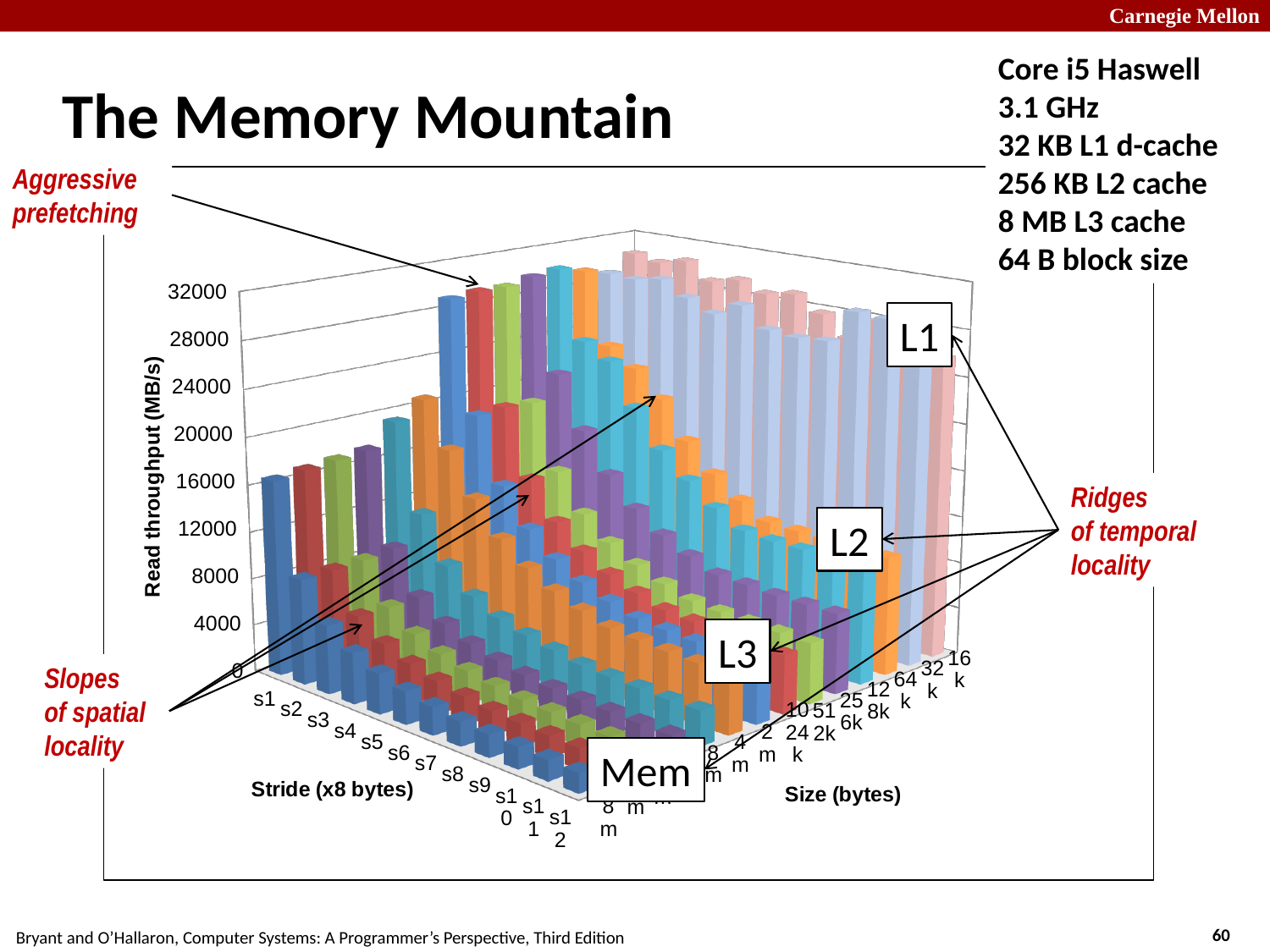
For a given size, does read throughput rise or fall as the stride increases from s1 to s12? fall How many stride categories (s1, s2, ...) are shown along the stride axis? 12 Is the highest read throughput shown in the chart greater or less than 24000 MB/s? greater What kind of chart is shown on the slide? bar chart Is the read throughput for stride s12 at size 8m greater or less than 8000 MB/s? less What is the title of the stride axis of the chart? Stride (x8 bytes) What is the title of the vertical axis of the chart? Read throughput (MB/s)